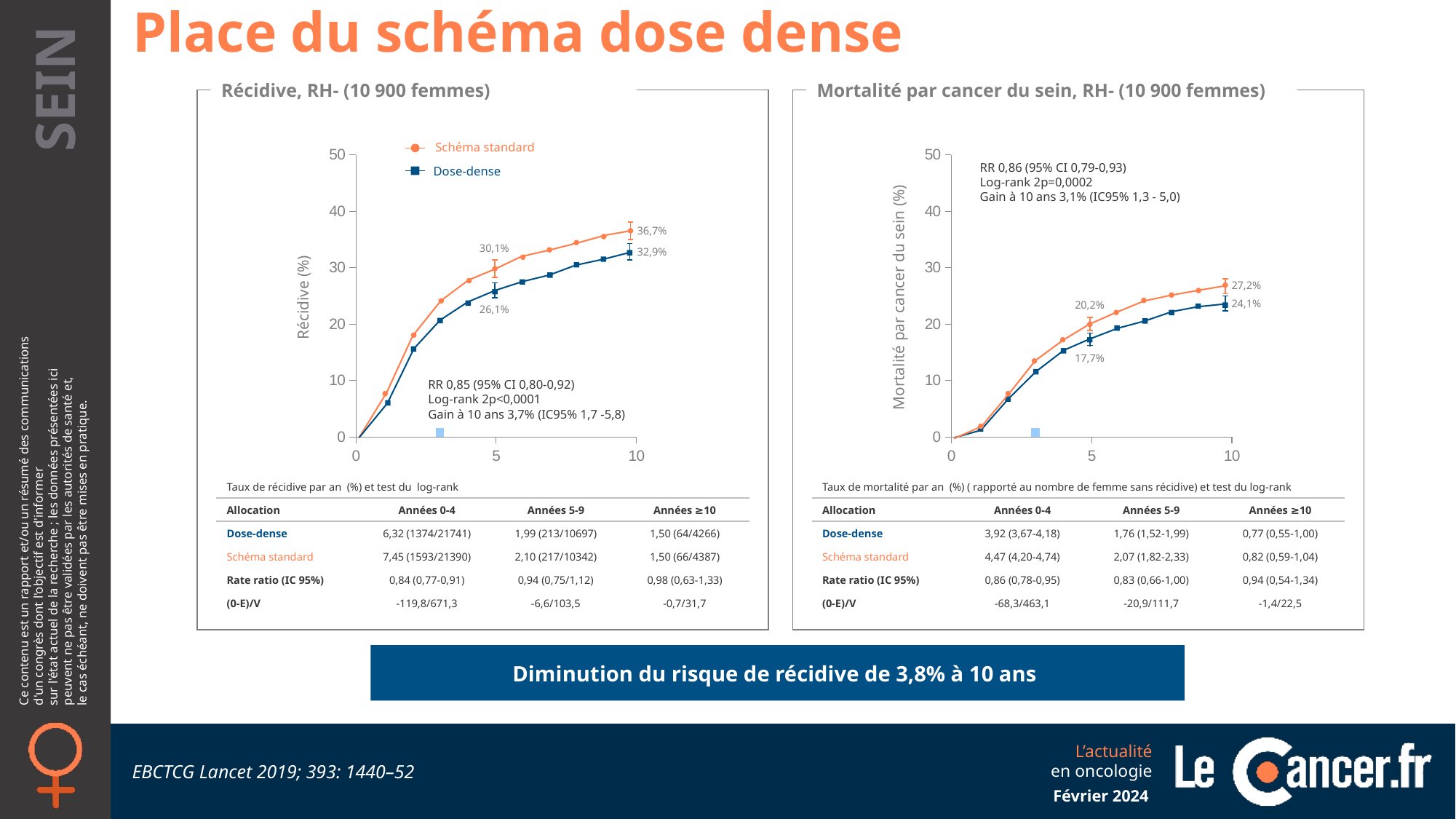
In the 'Récidive, RH- (10 900 femmes)' chart, what is the labelled value for Dose-dense at 5 years? 26,1% In the 'Récidive, RH- (10 900 femmes)' chart, what is the labelled recurrence value for Schéma standard at 10 years? 36,7% In the 'Mortalité par cancer du sein, RH- (10 900 femmes)' chart, what is the labelled mortality value for Schéma standard at 10 years? 27,2% In the 'Mortalité par cancer du sein, RH- (10 900 femmes)' chart, what is the difference between the labelled 10-year values of Schéma standard (27,2%) and Dose-dense (24,1%)? 3,1% In the 'Récidive, RH- (10 900 femmes)' chart, what is the labelled recurrence value for Dose-dense at 10 years? 32,9% In the 'Récidive, RH- (10 900 femmes)' chart, what is the difference between the labelled 5-year values of Schéma standard (30,1%) and Dose-dense (26,1%)? 4,0% In the 'Mortalité par cancer du sein, RH- (10 900 femmes)' chart, which curve is higher at 10 years, Schéma standard or Dose-dense? Schéma standard In the 'Récidive, RH- (10 900 femmes)' chart, do the curves rise or fall as the years increase along the x axis? Rise How many series does the legend of the 'Récidive, RH- (10 900 femmes)' chart list? 2 In the 'Mortalité par cancer du sein, RH- (10 900 femmes)' chart, what is the labelled mortality value for Dose-dense at 5 years? 17,7% What kind of chart is the 'Récidive, RH- (10 900 femmes)' chart? Line chart In the 'Récidive, RH- (10 900 femmes)' chart, is the Dose-dense value at 10 years greater or less than 30? greater